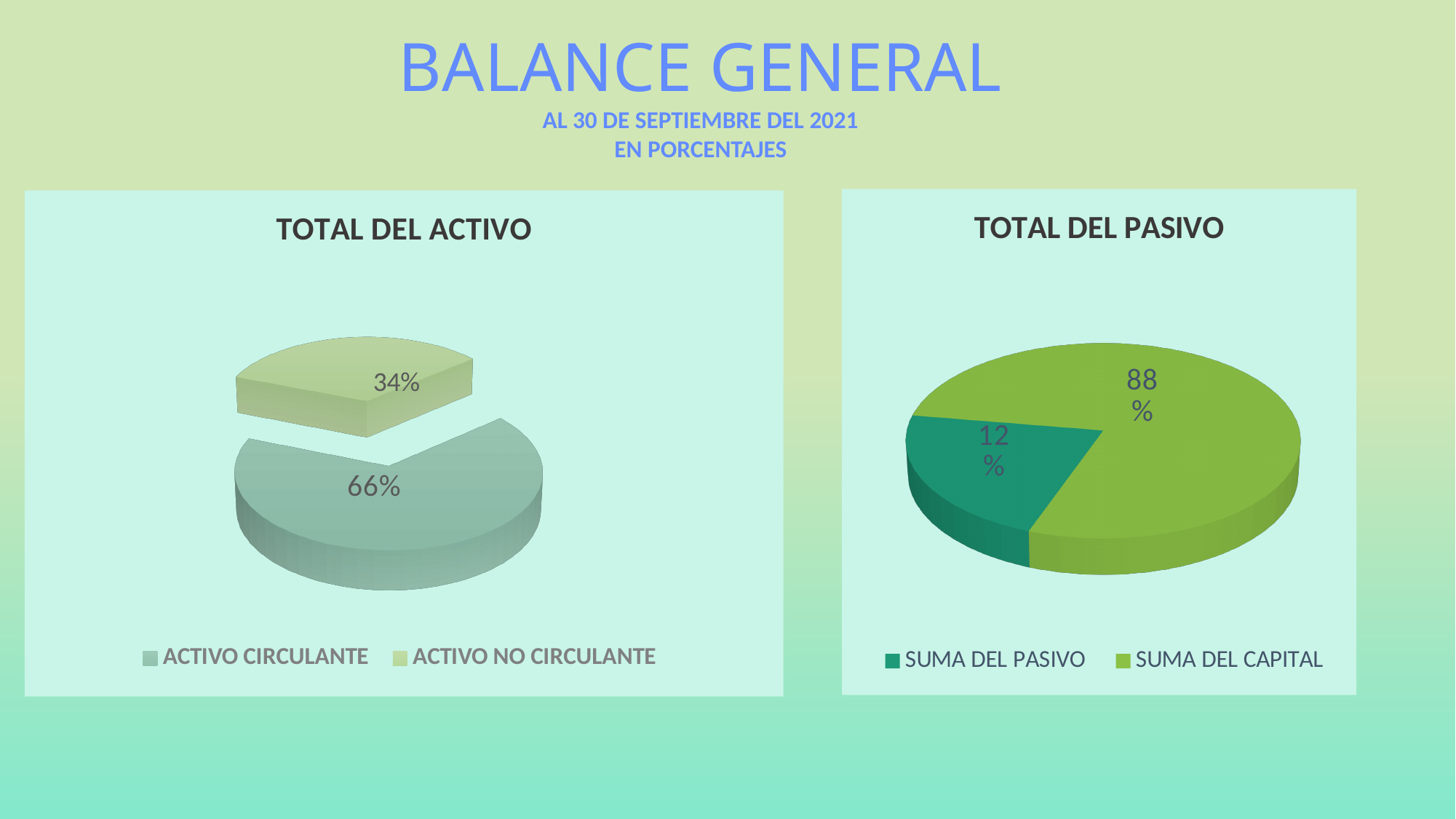
In the 'TOTAL DEL PASIVO' chart, what percentage is shown for SUMA DEL CAPITAL? 88% In the 'TOTAL DEL PASIVO' chart, which category has the smallest slice? SUMA DEL PASIVO How many slices does the 'TOTAL DEL PASIVO' chart have? 2 In the 'TOTAL DEL PASIVO' chart, which is larger, SUMA DEL PASIVO or SUMA DEL CAPITAL? SUMA DEL CAPITAL What kind of chart is the 'TOTAL DEL ACTIVO' chart? Pie chart What are the two legend entries of the 'TOTAL DEL ACTIVO' chart? ACTIVO CIRCULANTE and ACTIVO NO CIRCULANTE In the 'TOTAL DEL ACTIVO' chart, what percentage is shown for ACTIVO NO CIRCULANTE? 34% In the 'TOTAL DEL PASIVO' chart, what percentage is shown for SUMA DEL PASIVO? 12% In the 'TOTAL DEL ACTIVO' chart, which category has the largest slice? ACTIVO CIRCULANTE In the 'TOTAL DEL ACTIVO' chart, what is the difference in percentage points between ACTIVO CIRCULANTE and ACTIVO NO CIRCULANTE? 32 In the 'TOTAL DEL ACTIVO' chart, what percentage is shown for ACTIVO CIRCULANTE? 66% In the 'TOTAL DEL PASIVO' chart, what is the difference in percentage points between SUMA DEL CAPITAL and SUMA DEL PASIVO? 76